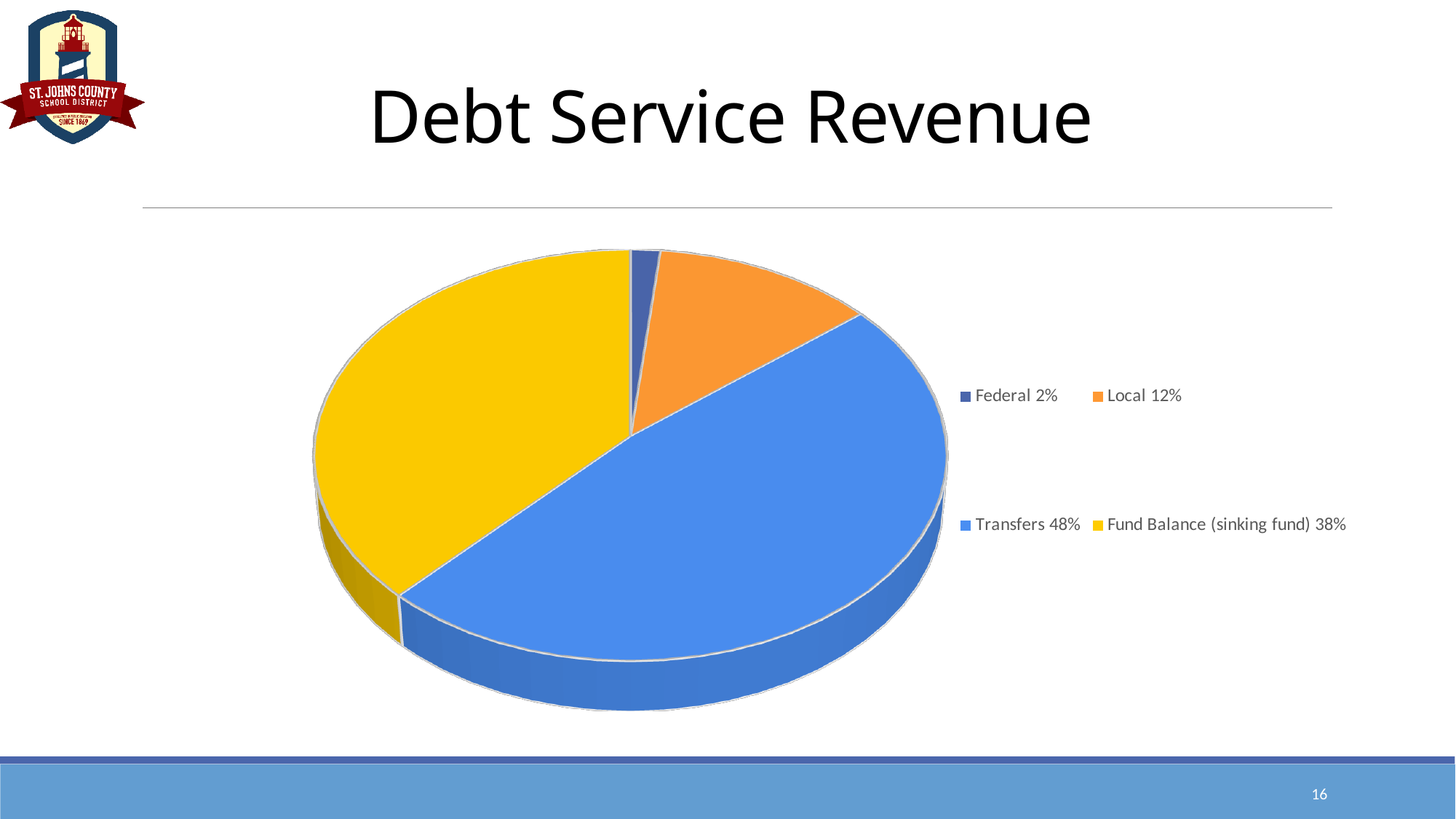
What share of Debt Service Revenue comes from Fund Balance (sinking fund)? 38% Which category has the smallest share of Debt Service Revenue? Federal What is the difference in percentage points between Transfers and Fund Balance (sinking fund)? 10 What share of Debt Service Revenue comes from Local? 12% Which is larger, the Local share or the Federal share? Local What is the difference in percentage points between Local and Federal? 10 What share of Debt Service Revenue comes from Federal? 2% What kind of chart is shown on the slide? pie chart How many categories does the pie chart show? 4 Which category has the largest share of Debt Service Revenue? Transfers What is the title of the chart? Debt Service Revenue